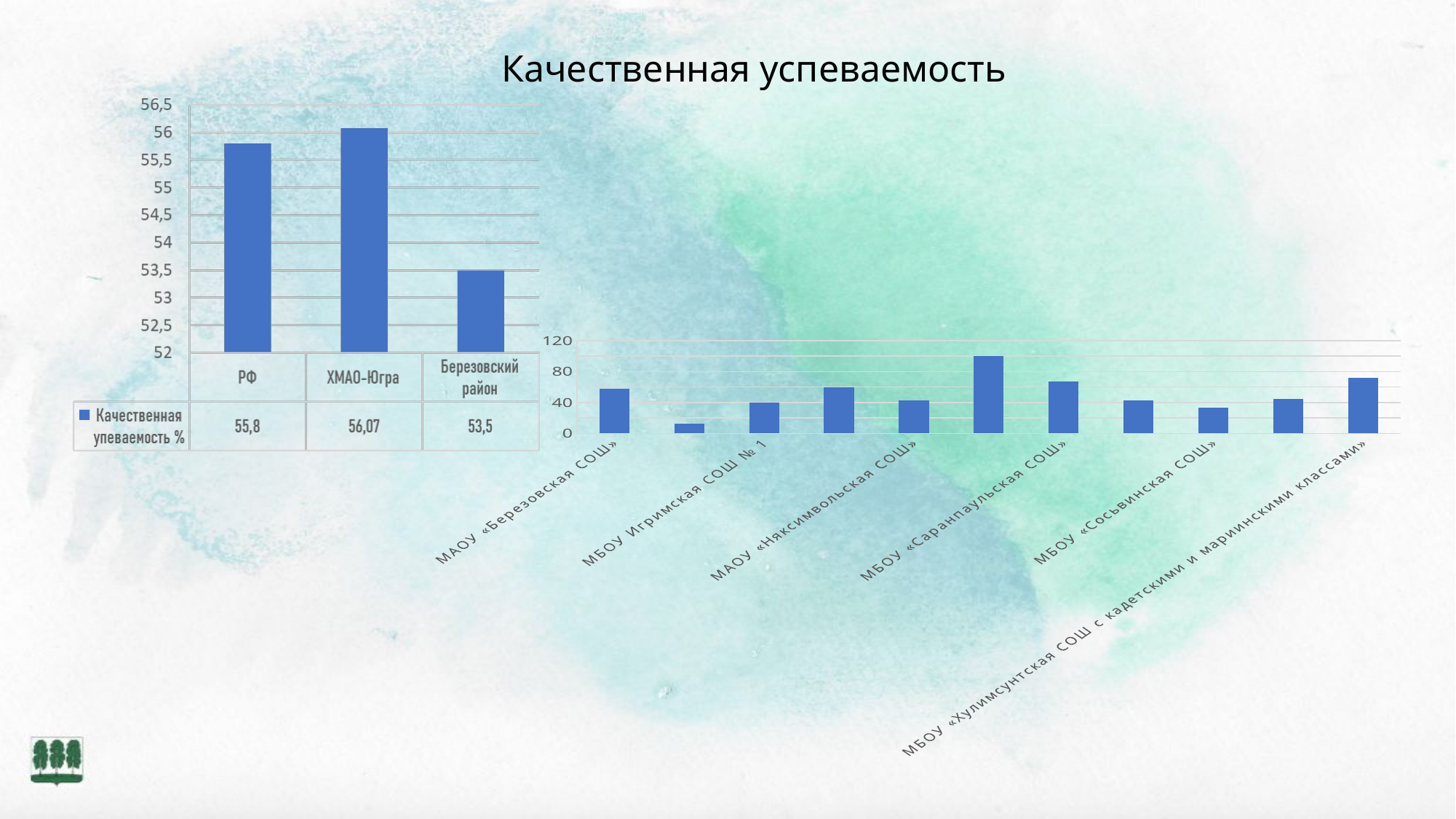
In the left chart, what is the difference between the values for РФ and Березовский район? 2,3 In the left chart, which is larger: the value for РФ or the value for ХМАО-Югра? ХМАО-Югра In the left chart, what is the value for ХМАО-Югра? 56,07 What kind of chart is the right chart? bar chart In the right chart, is the value for МБОУ «Саранпаульская СОШ» greater or less than 80? less In the left chart, which category has the highest value? ХМАО-Югра In the left chart, what is the value for РФ? 55,8 In the right chart, how many bars are plotted? 11 In the left chart, what is the name of the series shown in the legend? Качественная упеваемость % In the left chart, which category has the lowest value? Березовский район In the left chart, what is the value for Березовский район? 53,5